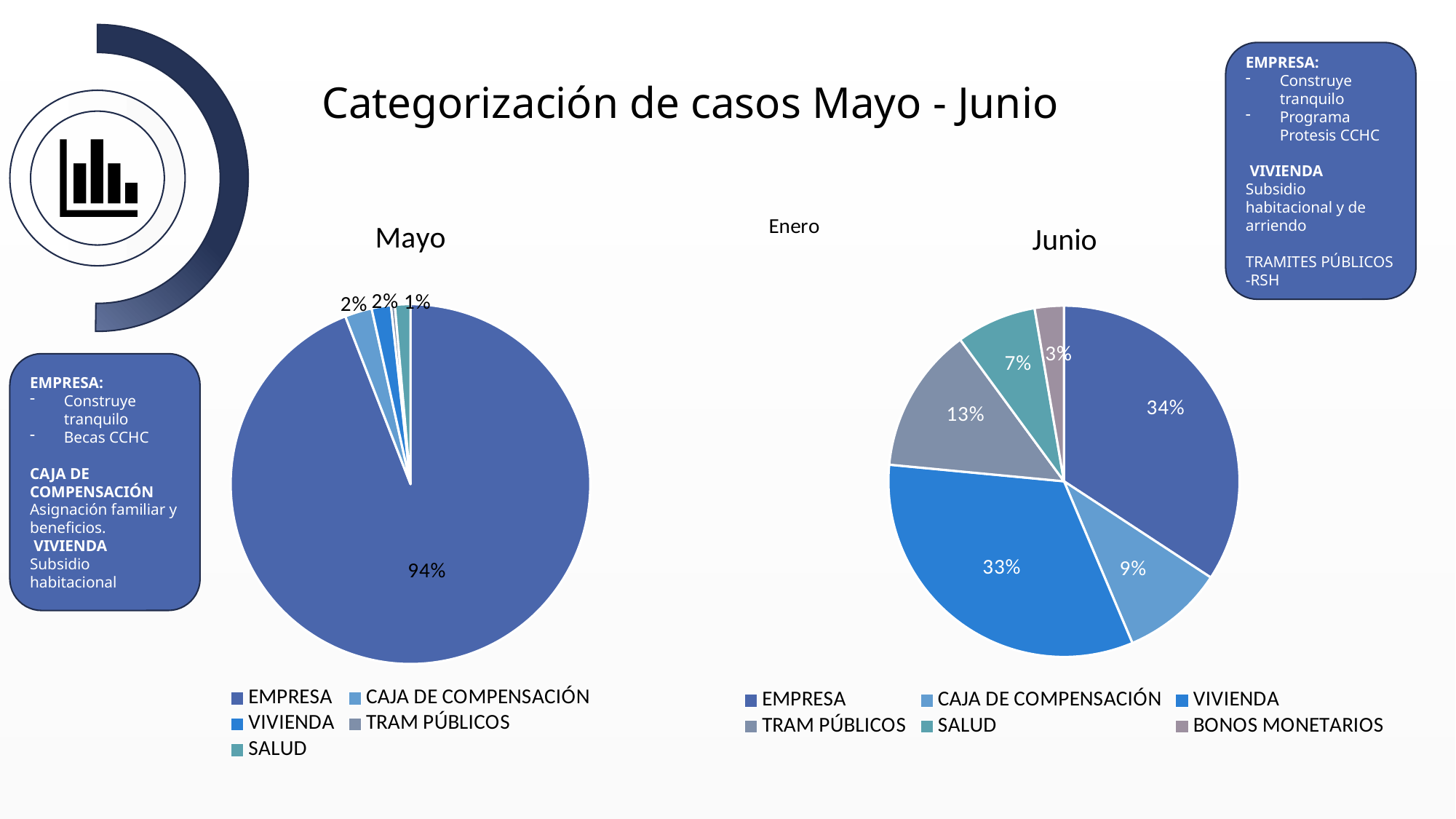
In the Junio pie chart, what share is shown for EMPRESA? 34% In the Junio pie chart, which category has the largest slice? EMPRESA In the Mayo pie chart, what share is shown for EMPRESA? 94% In the Junio pie chart, what share is shown for CAJA DE COMPENSACIÓN? 9% In the Junio pie chart, how many percentage points larger is TRAM PÚBLICOS than SALUD? 6 percentage points In the Junio pie chart, which category has the smallest slice? BONOS MONETARIOS How many categories does the legend of the Junio pie chart list? 6 What kind of chart is used for Mayo and Junio? Pie chart